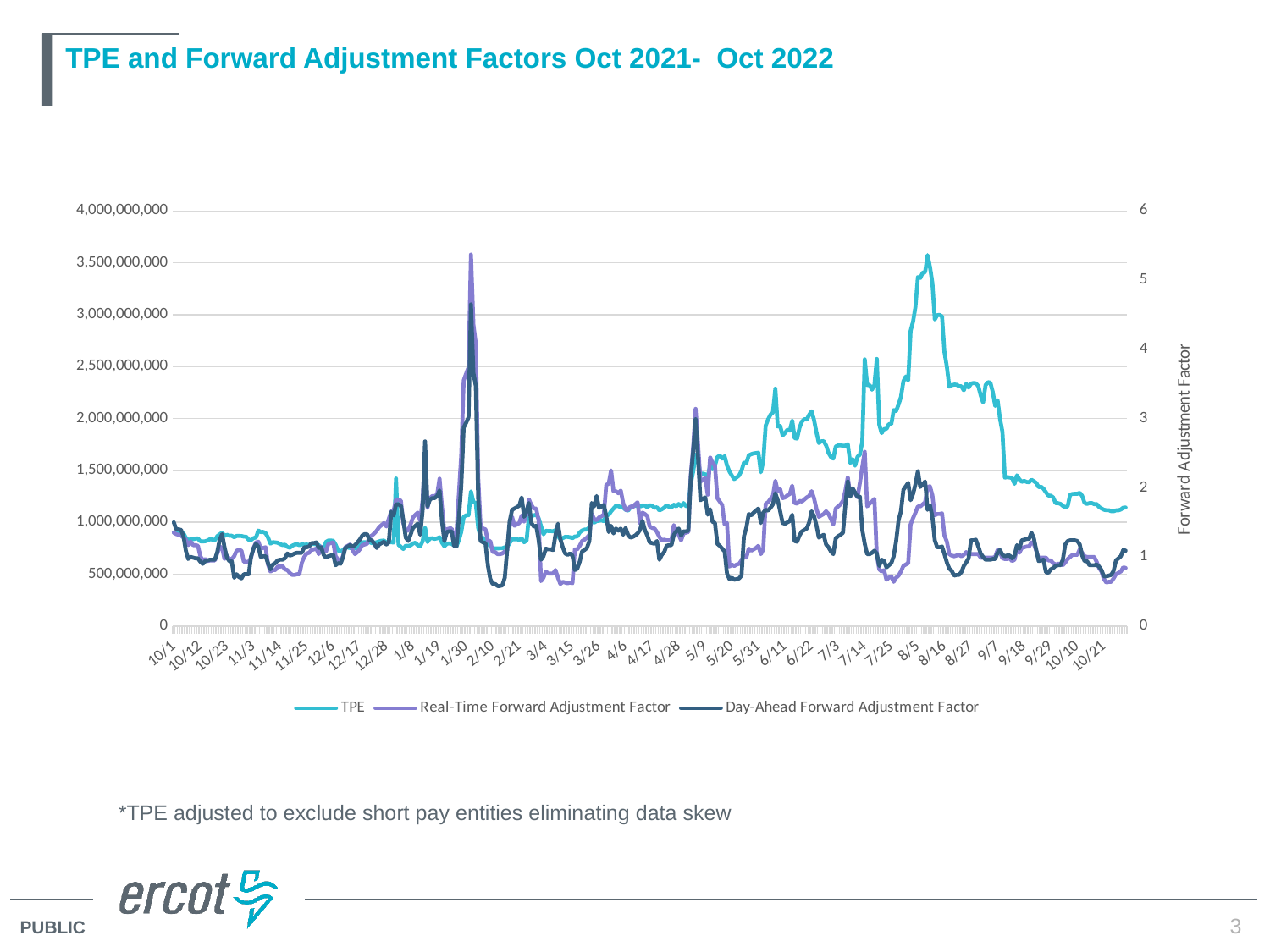
What is the title of the chart? TPE and Forward Adjustment Factors Oct 2021- Oct 2022 Is the peak of the Real-Time Forward Adjustment Factor (around 1/30) greater or less than 5 on the right axis? greater Is the Day-Ahead Forward Adjustment Factor around 2/10 greater or less than 1 on the right axis? less Is the peak of the Day-Ahead Forward Adjustment Factor (around 1/30) greater or less than 4 on the right axis? greater Which of the two forward adjustment factor series reaches the higher peak value? Real-Time Forward Adjustment Factor What kind of chart is shown on the slide? Line chart How many series does the legend list? 3 What is the label on the right-hand vertical axis? Forward Adjustment Factor Does the TPE series rise or fall between 8/16 and 10/21? Fall Does the TPE series rise or fall between 7/25 and 8/5? Rise